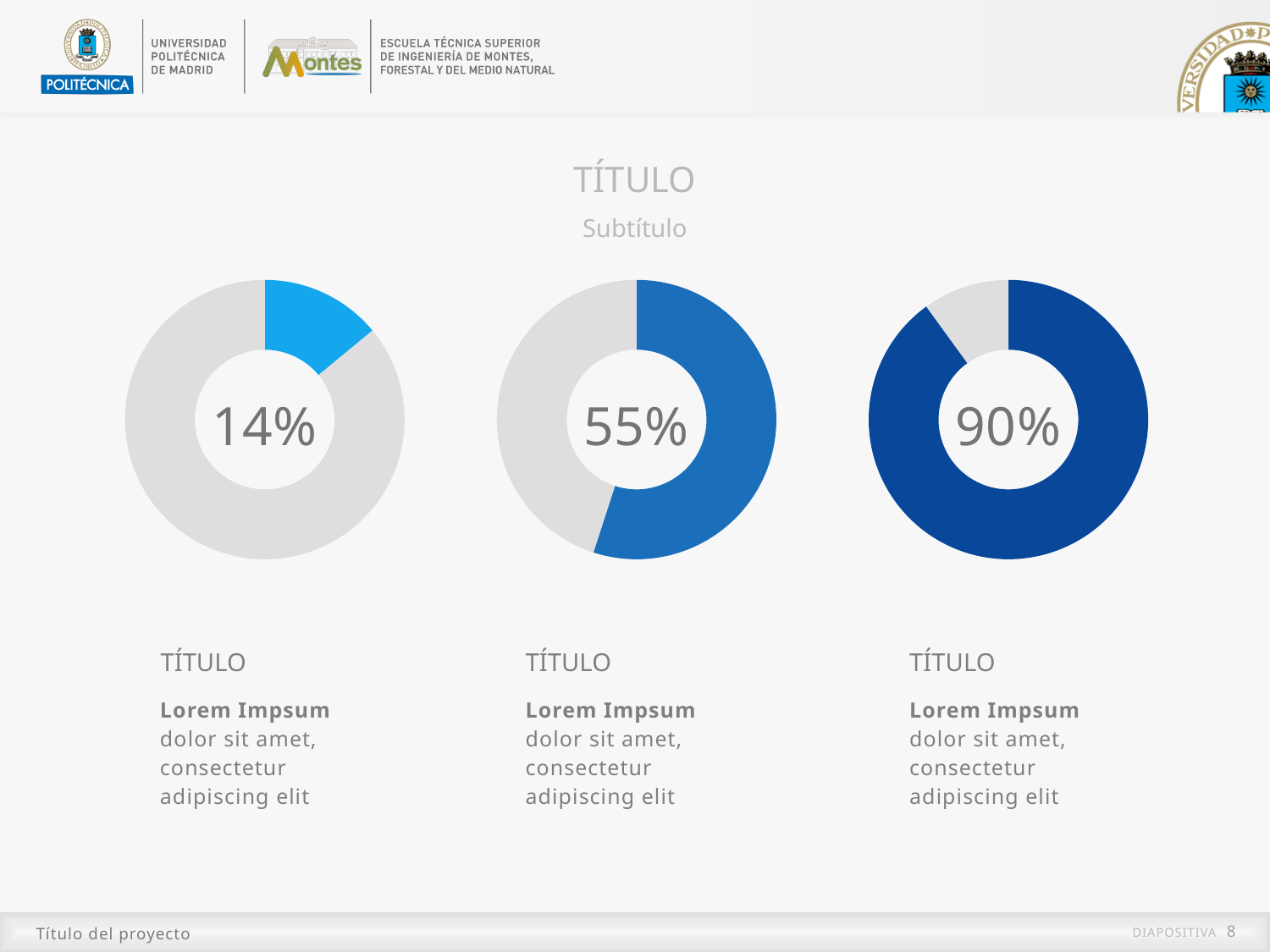
How many donut charts are shown on the slide? 3 What is the difference between the percentage in the right donut chart and the percentage in the left donut chart? 76% Is the percentage in the middle donut chart larger or smaller than the percentage in the right donut chart? Smaller What is the difference between the percentage in the middle donut chart and the percentage in the left donut chart? 41% What percentage is shown in the centre of the left donut chart? 14% What colour is the filled segment of the right donut chart? Dark blue What percentage is shown in the centre of the right donut chart? 90% In the middle donut chart, what share of the ring is filled with the coloured segment? 55% Which of the three donut charts shows the highest percentage? The right chart (90%) What percentage is shown in the centre of the middle donut chart? 55% What kind of chart is used three times on this slide? Donut (pie) chart Which of the three donut charts shows the lowest percentage? The left chart (14%)